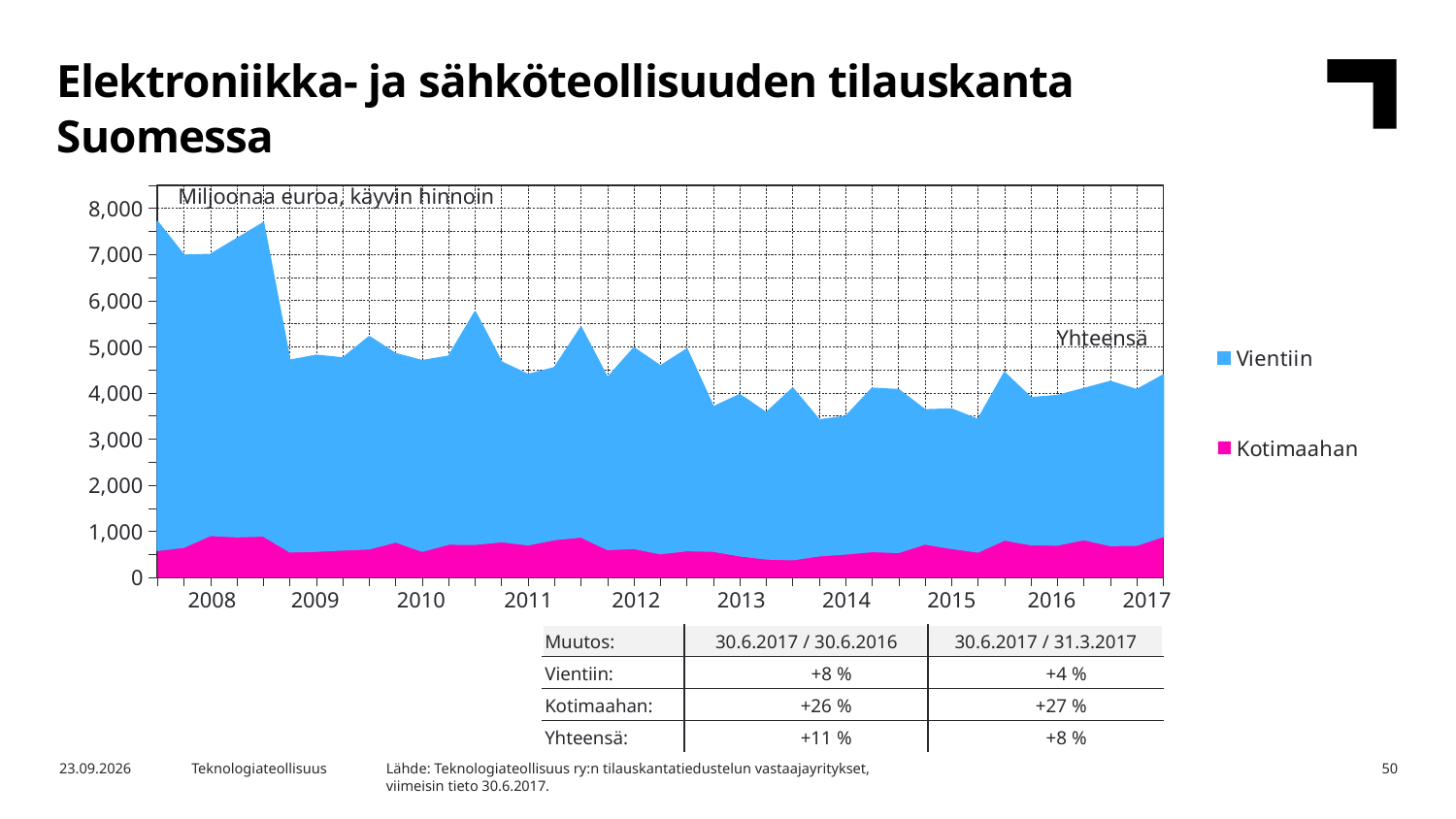
What kind of chart is shown on the slide? Stacked area chart How many series does the legend list? 2 What unit is stated at the top of the chart? Miljoonaa euroa, käyvin hinnoin Is the total order backlog in 2017 greater or less than 5,000? less Is the Kotimaahan value in 2017 greater or less than 1,000? less What are the two series named in the legend? Vientiin and Kotimaahan Which year has the highest total order backlog? 2008 Does the total order backlog rise or fall overall from 2008 to 2017? fall Which series is larger throughout the chart, Vientiin or Kotimaahan? Vientiin How many years are labelled on the x axis? 10 Is the total order backlog in 2014 greater or less than 5,000? less